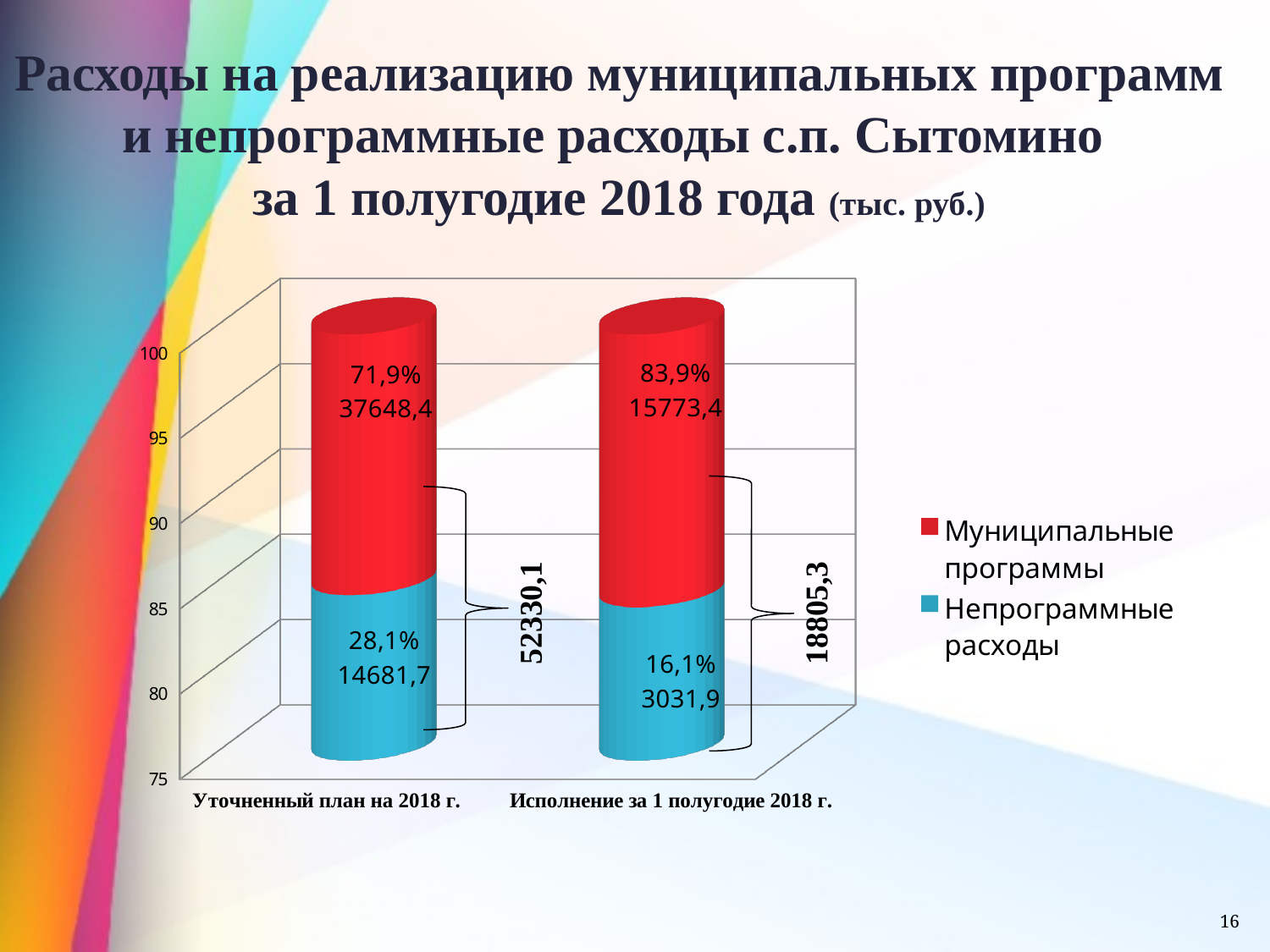
How many categories are shown on the x axis? 2 What is the value of Муниципальные программы for Уточненный план на 2018 г.? 37648,4 What is the difference between Муниципальные программы in Уточненный план на 2018 г. and in Исполнение за 1 полугодие 2018 г.? 21875,0 Which is larger: Непрограммные расходы in Уточненный план на 2018 г. or in Исполнение за 1 полугодие 2018 г.? Уточненный план на 2018 г. How many series does the legend list? 2 Which category has the higher total expenditure? Уточненный план на 2018 г. What kind of chart is shown on the slide? Stacked bar chart What is the value of Непрограммные расходы for Исполнение за 1 полугодие 2018 г.? 3031,9 What percentage share do Муниципальные программы make up in Исполнение за 1 полугодие 2018 г.? 83,9% What is the total shown for the Уточненный план на 2018 г. bar? 52330,1 What percentage share do Непрограммные расходы make up in Уточненный план на 2018 г.? 28,1% What is the total shown for the Исполнение за 1 полугодие 2018 г. bar? 18805,3